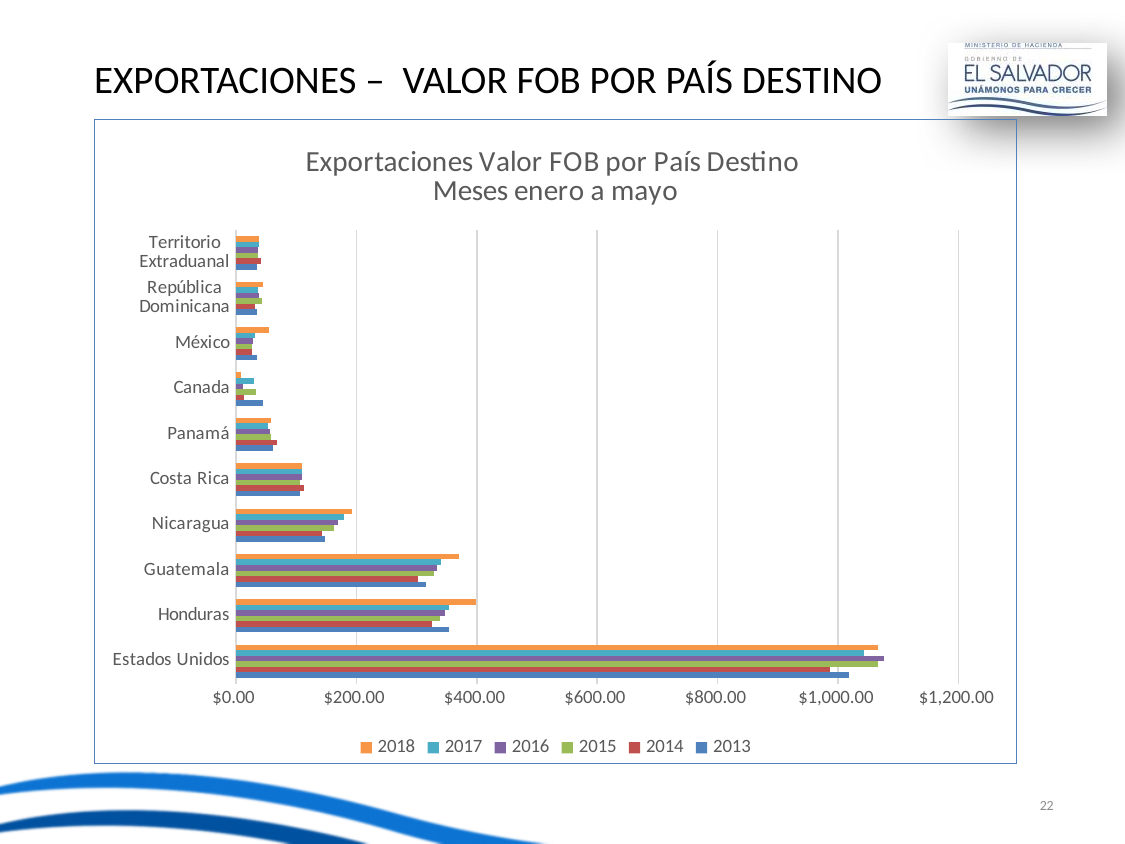
How many countries/destinations are listed on the chart? 10 Is the 2013 value for Estados Unidos greater or less than $800.00? greater Which is larger in 2018, the value for Panamá or the value for Canada? Panamá Which is larger in 2018, the value for Guatemala or the value for Nicaragua? Guatemala How many series does the legend list? 6 Which destination has the highest export value in 2018? Estados Unidos Is the 2018 value for Guatemala greater or less than $400.00? less What is the title of the chart? Exportaciones Valor FOB por País Destino Meses enero a mayo Is the 2018 value for Estados Unidos greater or less than $1,000.00? greater Which destination has the lowest export value in 2018? Canada What kind of chart is shown on the slide? bar chart